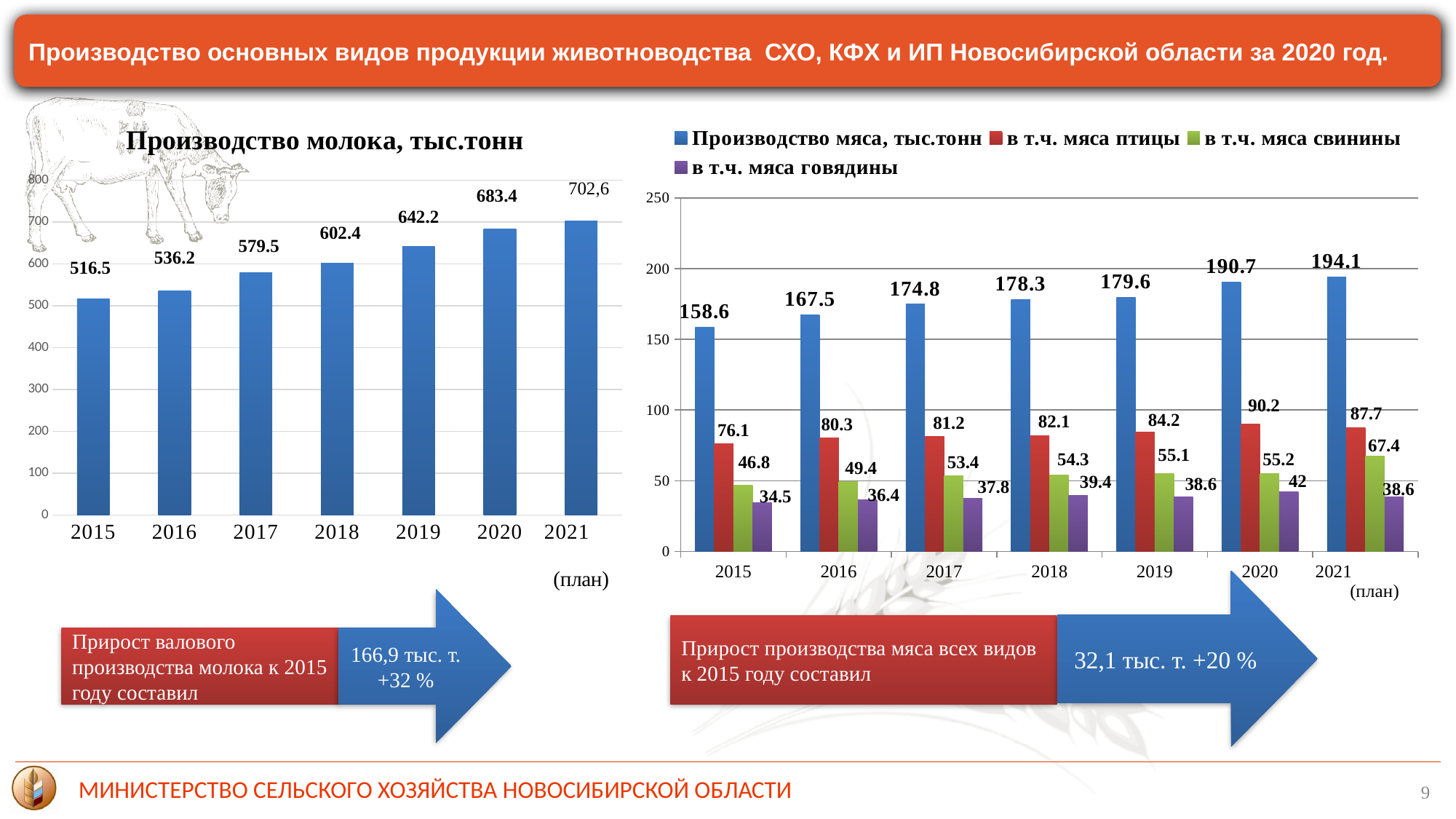
In the chart titled "Производство молока, тыс.тонн", do the values rise or fall from 2015 to 2021? rise In the right-hand meat production chart, how many series does the legend list? 4 In the right-hand meat production chart, what is the value of "Производство мяса, тыс.тонн" for 2019? 179.6 In the chart titled "Производство молока, тыс.тонн", which year has the lowest value? 2015 In the chart titled "Производство молока, тыс.тонн", what is the difference between the 2020 value and the 2015 value? 166.9 In the chart titled "Производство молока, тыс.тонн", how many years are shown on the x axis? 7 In the chart titled "Производство молока, тыс.тонн", what is the value for 2018? 602.4 In the right-hand meat production chart, what is the value of "в т.ч. мяса свинины" for 2021 (план)? 67.4 In the right-hand meat production chart, which year has the highest value for "в т.ч. мяса птицы"? 2020 What kind of chart is the chart titled "Производство молока, тыс.тонн"? bar chart In the right-hand meat production chart, which is larger in 2017: "в т.ч. мяса свинины" or "в т.ч. мяса говядины"? в т.ч. мяса свинины In the right-hand meat production chart, what is the difference between "Производство мяса, тыс.тонн" in 2020 and in 2015? 32.1